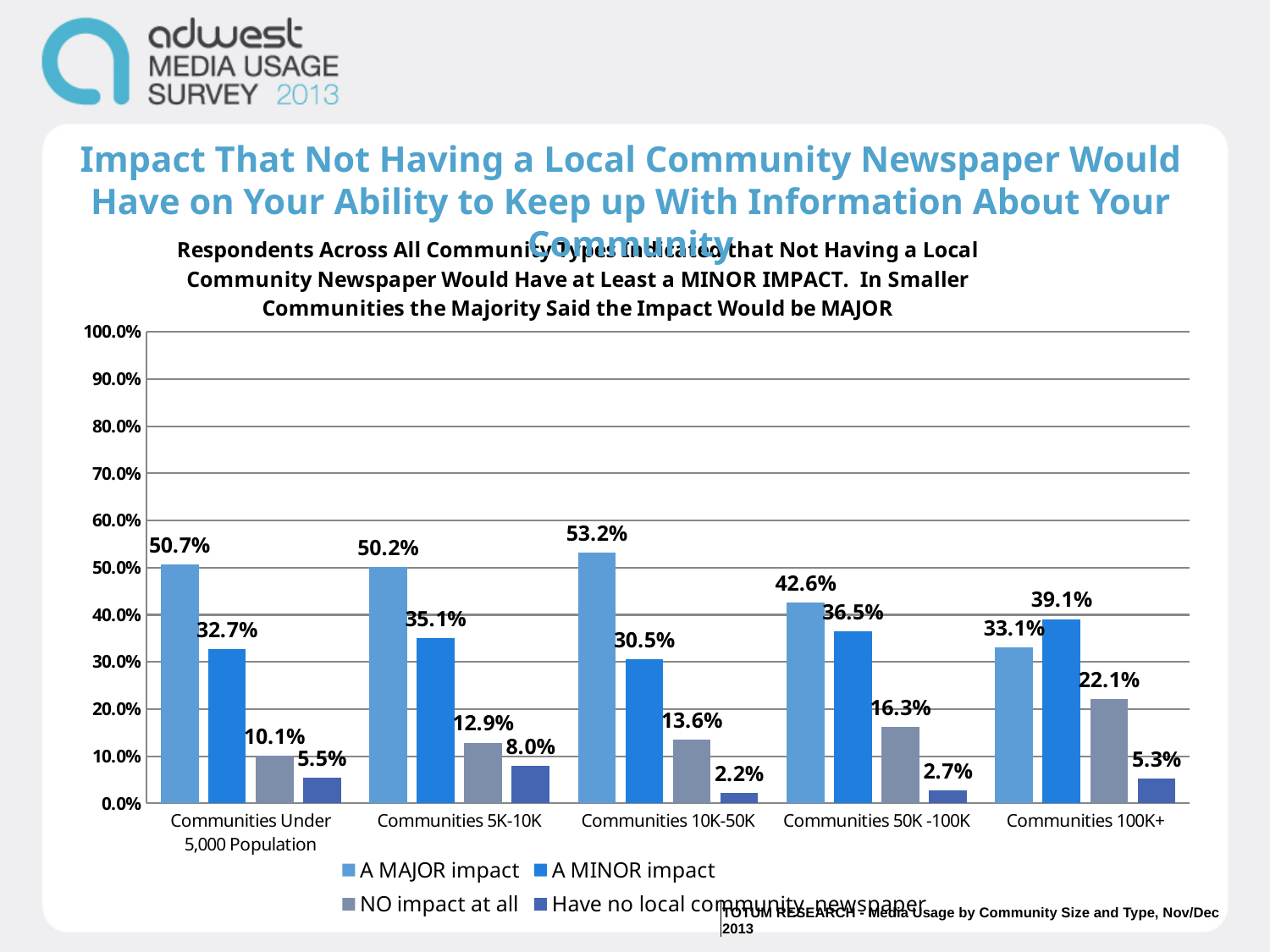
How many community types are shown on the x axis? 5 In Communities 100K+, which is larger: 'A MAJOR impact' or 'A MINOR impact'? A MINOR impact What kind of chart is shown on the slide? Bar chart Which community type has the lowest value for 'Have no local community newspaper'? Communities 10K-50K What is the difference between 'A MAJOR impact' and 'A MINOR impact' in Communities Under 5,000 Population? 18.0% What is the value for 'NO impact at all' in Communities 100K+? 22.1% What percentage of respondents in Communities 10K-50K said not having a local community newspaper would have a MAJOR impact? 53.2% Which community type has the highest value for 'A MAJOR impact'? Communities 10K-50K Is the value for 'A MAJOR impact' in Communities 50K -100K greater or less than 50.0%? less What is the value for 'Have no local community newspaper' in Communities 5K-10K? 8.0% What is the difference between 'NO impact at all' in Communities 100K+ and in Communities Under 5,000 Population? 12.0% How many series does the legend list? 4